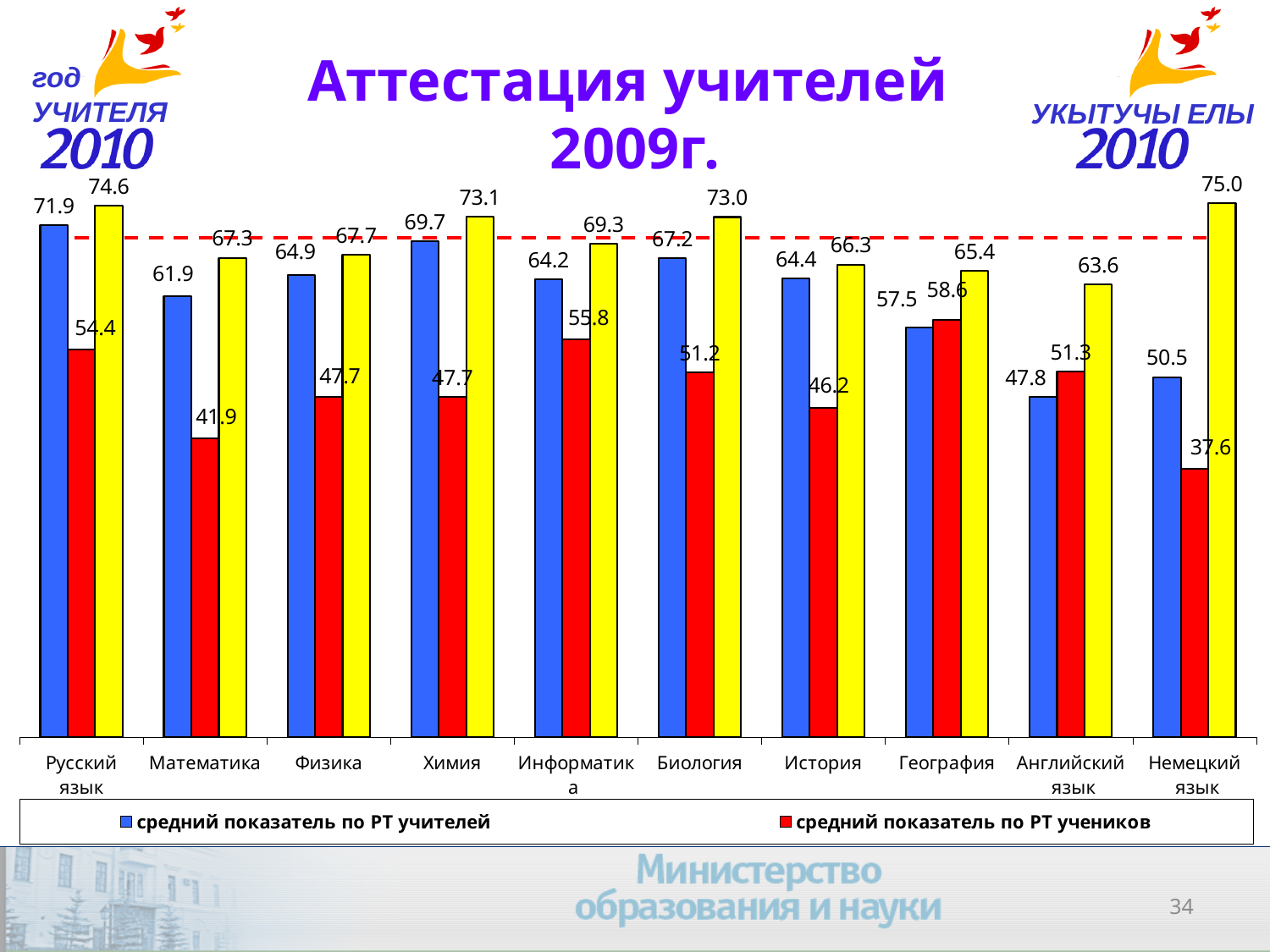
Which subject has the highest average teacher score (blue bars)? Русский язык Which subject has the lowest average student score (red bars)? Немецкий язык For География, which is larger: the teacher score or the student score? the student score (58.6) How many series does the legend list? 2 What is the difference between the teacher score and the student score for Химия? 22.0 What colour are the bars for средний показатель по РТ учеников? red What is the value of the yellow bar for Немецкий язык? 75.0 What is the average student score (средний показатель по РТ учеников) for Математика? 41.9 What kind of chart is shown on the slide? bar chart How many subjects are shown on the x axis? 10 What is the title of the chart? Аттестация учителей 2009г. What is the average teacher score (средний показатель по РТ учителей) for Русский язык? 71.9